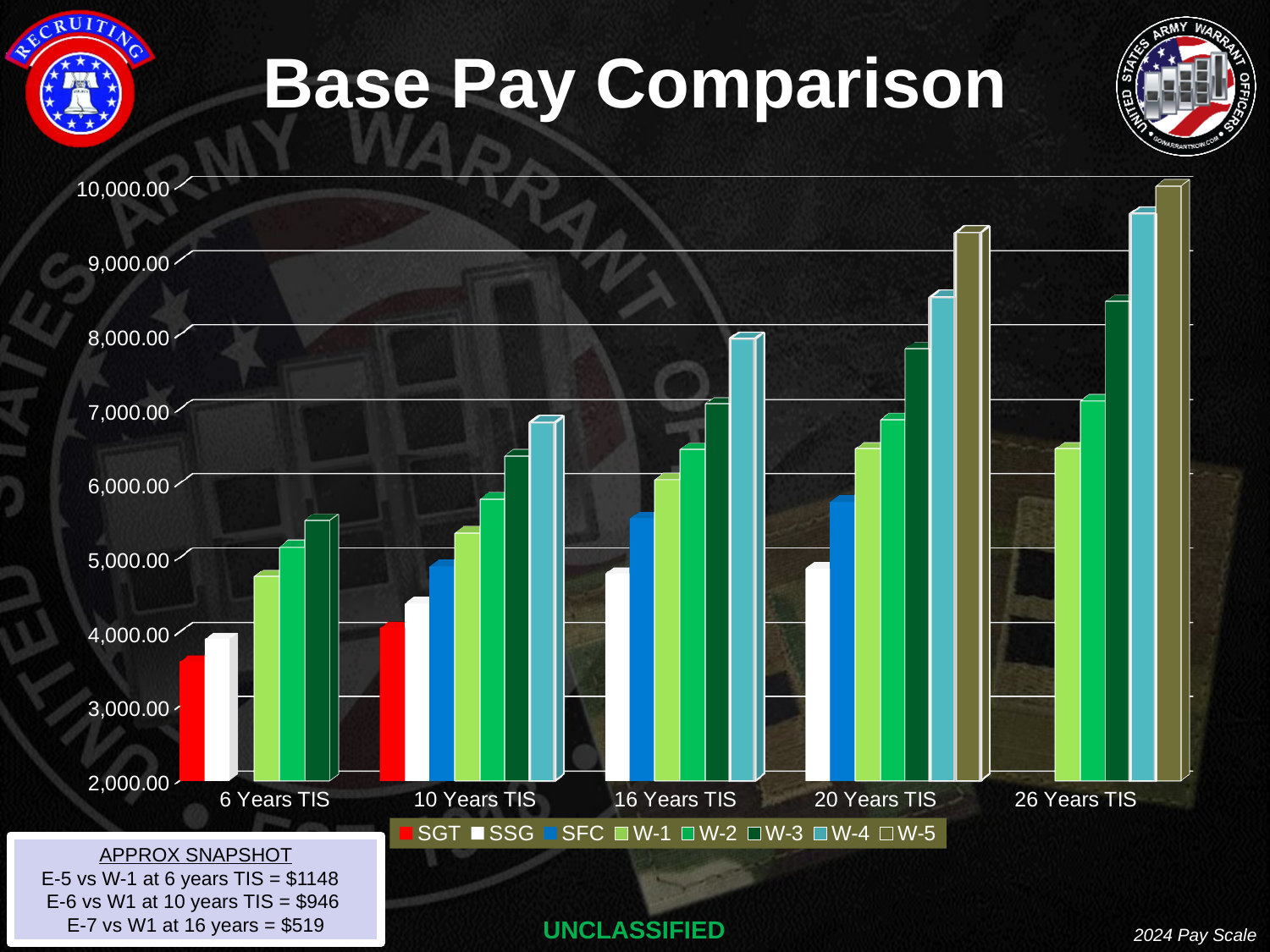
Is the value for SGT at 6 Years TIS greater or less than 4,000.00? less At 16 Years TIS, which is larger, the W-3 bar or the W-4 bar? W-4 How many series does the chart legend list? 8 Is the value for W-5 at 20 Years TIS greater or less than 9,000.00? greater How many Years TIS categories are shown on the x axis? 5 Which series has the tallest bar in the 26 Years TIS category? W-5 Do the W-1 values rise or fall as Years TIS increases along the x axis? Rise Which series has the shortest bar in the 6 Years TIS category? SGT What is the title of the chart? Base Pay Comparison What type of chart is shown on the slide? Bar chart What colour is used for the SGT series in the chart? Red Is the value for W-4 at 16 Years TIS greater or less than 7,000.00? greater